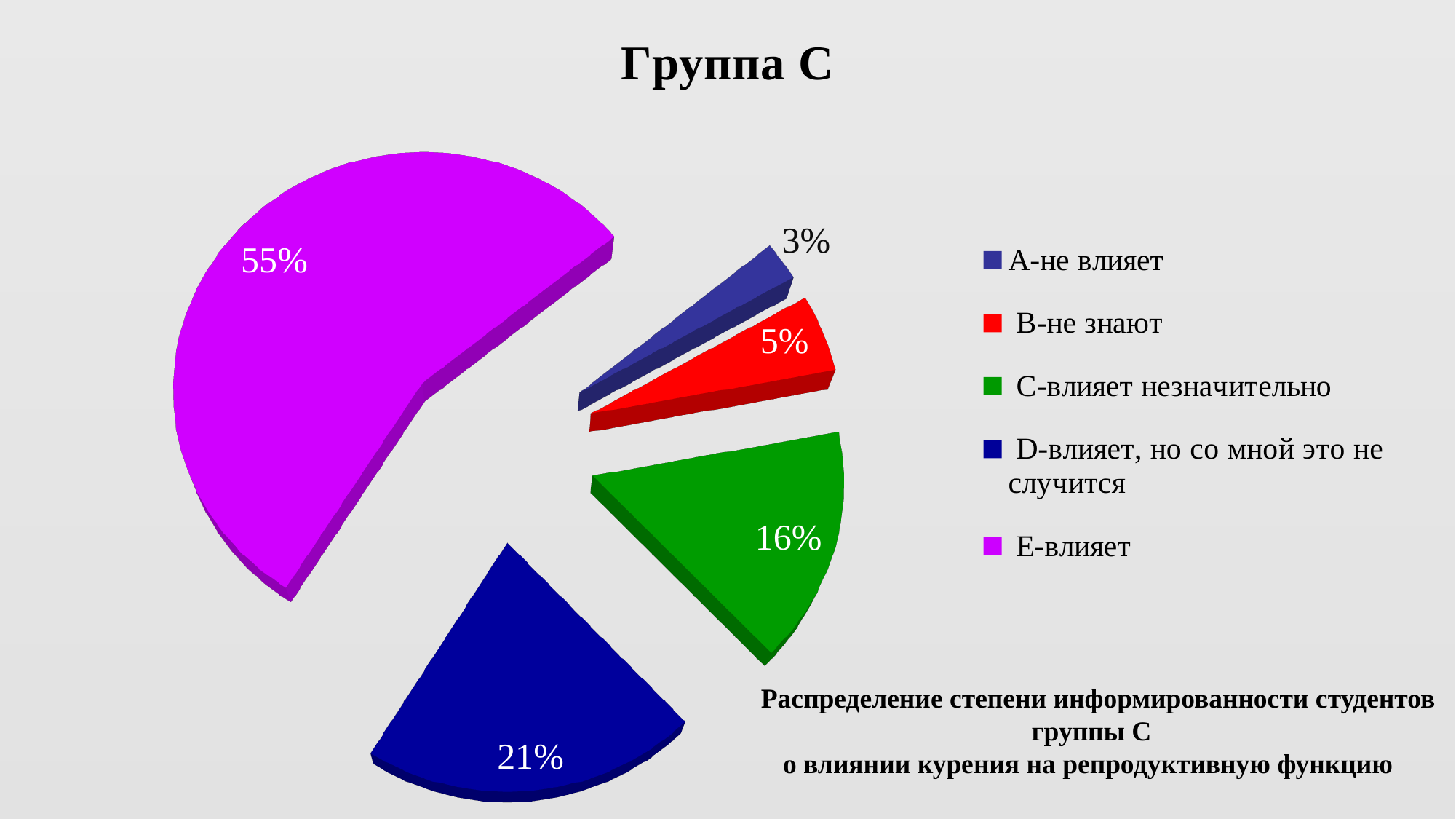
Which is larger, the slice for 'C-влияет незначительно' or the slice for 'B-не знают'? C-влияет незначительно What kind of chart is shown on the slide? pie chart What is the chart's title? Группа С What is the value for 'B-не знают'? 5% What is the difference between the values for 'E-влияет' and 'D-влияет, но со мной это не случится'? 34% What share of the pie does the slice 'D-влияет, но со мной это не случится' have? 21% What share of the pie does the slice 'E-влияет' have? 55% What is the value for 'A-не влияет'? 3% Which category has the smallest slice? A-не влияет What is the value for 'C-влияет незначительно'? 16% Which category has the largest slice? E-влияет How many categories does the legend list? 5